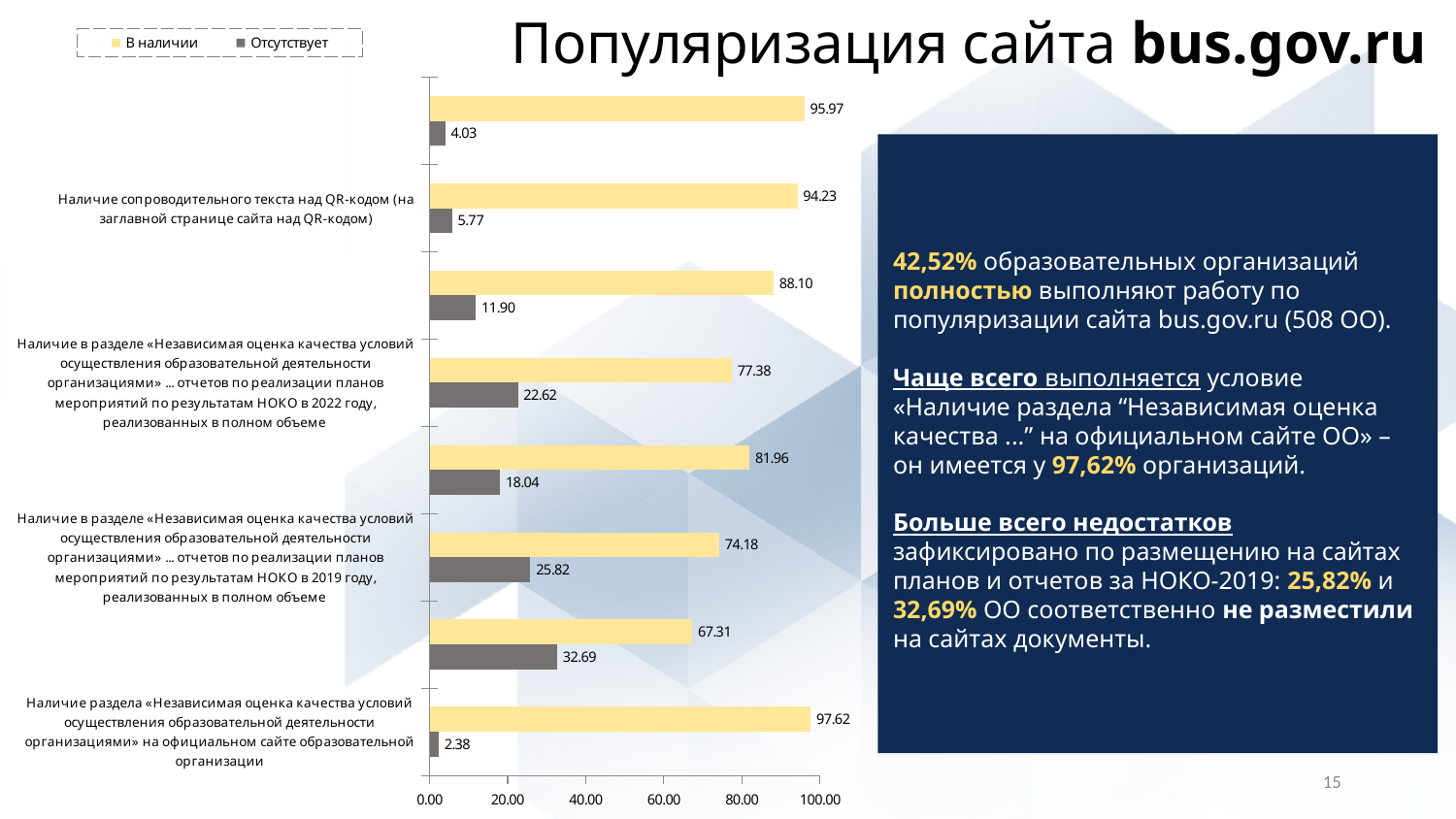
What are the two series named in the chart legend? В наличии and Отсутствует How many categories (pairs of bars) are plotted in the chart? 8 What is the highest 'Отсутствует' value shown in the chart? 32.69 How many series does the chart legend list? 2 Which category has the highest 'В наличии' value in the chart? Наличие раздела «Независимая оценка качества условий осуществления образовательной деятельности организациями» на официальном сайте образовательной организации What kind of chart is shown on the slide? bar chart What is the 'В наличии' value for 'Наличие раздела «Независимая оценка качества условий осуществления образовательной деятельности организациями» на официальном сайте образовательной организации'? 97.62 What is the 'Отсутствует' value for the category about reports on plans based on НОКО results in 2019? 25.82 What is the lowest 'В наличии' value shown in the chart? 67.31 What is the 'Отсутствует' value for 'Наличие сопроводительного текста над QR-кодом (на заглавной странице сайта над QR-кодом)'? 5.77 What is the difference between the 'В наличии' and 'Отсутствует' values for 'Наличие сопроводительного текста над QR-кодом (на заглавной странице сайта над QR-кодом)'? 88.46 What is the 'В наличии' value for the category about reports on plans based on НОКО results in 2022? 77.38